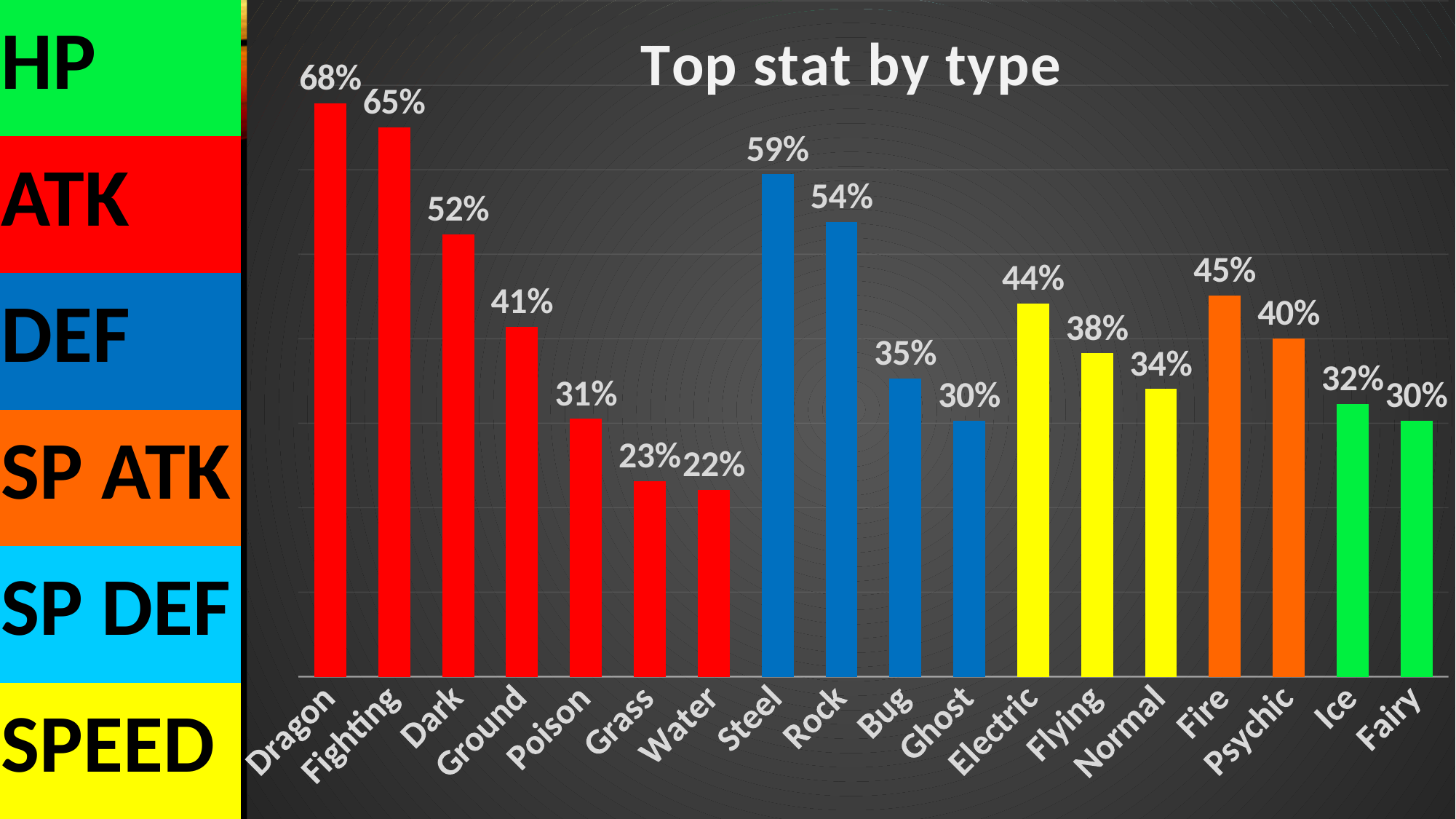
What is the difference between the values for Fighting and Dark in the 'Top stat by type' chart? 13% Which has a larger value in the 'Top stat by type' chart, Electric or Fire? Fire What colour are the bars for Electric, Flying and Normal in the 'Top stat by type' chart? Yellow What is the difference between the values for Steel and Rock in the 'Top stat by type' chart? 5% Which type has the lowest value in the 'Top stat by type' chart? Water What is the value for Dragon in the 'Top stat by type' chart? 68% How many types are shown on the x axis of the 'Top stat by type' chart? 18 Which type has the highest value in the 'Top stat by type' chart? Dragon What is the value for Psychic in the 'Top stat by type' chart? 40% What is the value for Fairy in the 'Top stat by type' chart? 30% What kind of chart is 'Top stat by type'? Bar chart What is the value for Steel in the 'Top stat by type' chart? 59%